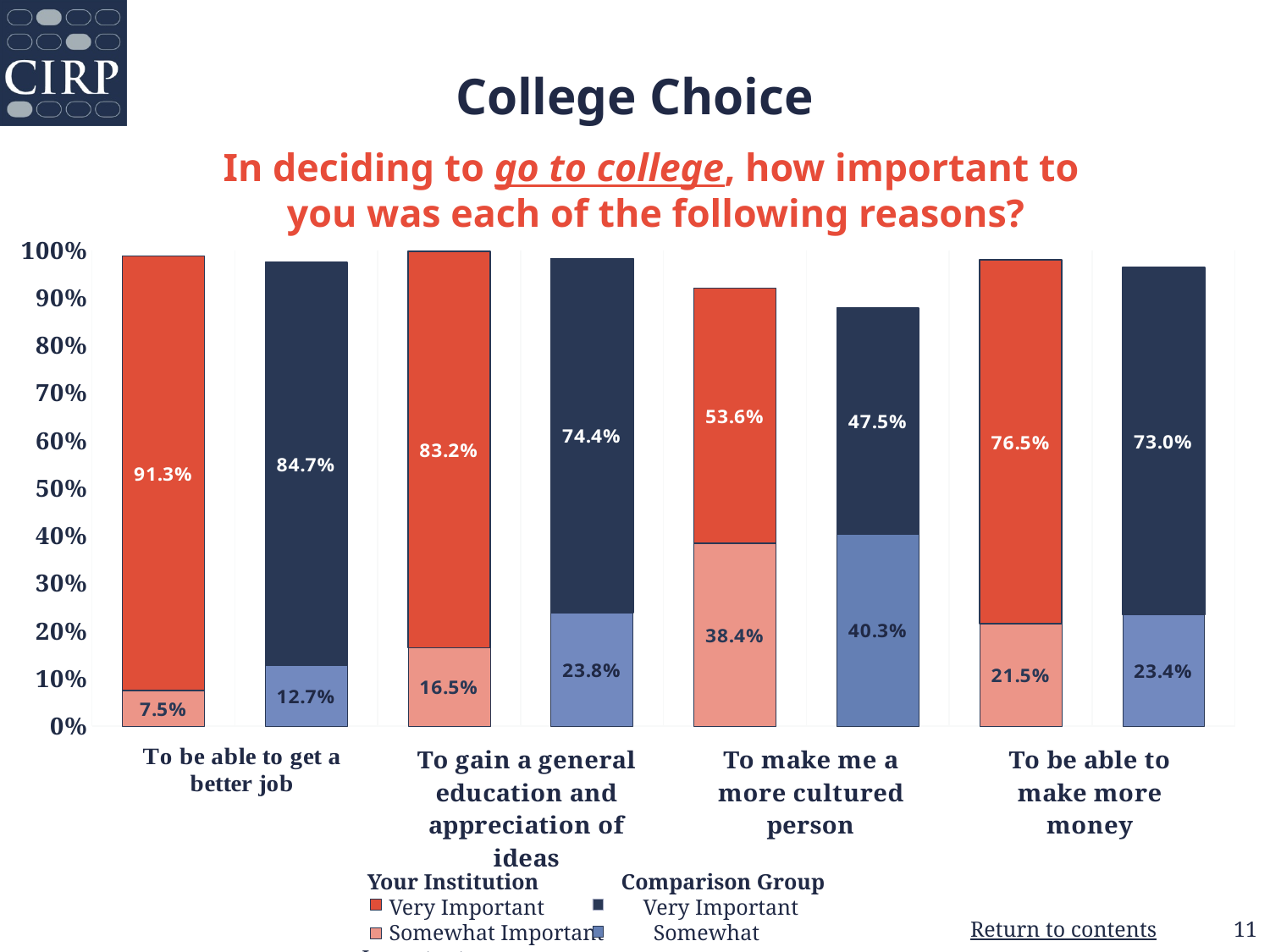
What is the Very Important percentage for the Comparison Group for "To be able to make more money"? 73.0% Which reason has the highest Very Important percentage for Your Institution? To be able to get a better job For "To be able to make more money", which is larger: the Your Institution Somewhat Important value or the Comparison Group Somewhat Important value? Comparison Group Somewhat Important Which reason has the lowest Very Important percentage for the Comparison Group? To make me a more cultured person What is the combined total of Very Important and Somewhat Important for the Comparison Group for "To be able to get a better job"? 97.4% What percentage of the Comparison Group rated "To make me a more cultured person" as Somewhat Important? 40.3% What percentage of Your Institution students rated "To be able to get a better job" as Very Important? 91.3% What is the combined total of Very Important and Somewhat Important for Your Institution for "To make me a more cultured person"? 92.0% What kind of chart is shown on the slide? Stacked bar chart What is the difference between the Your Institution and Comparison Group Very Important percentages for "To gain a general education and appreciation of ideas"? 8.8% How many series does the chart's legend list? 4 How many reasons (categories) are shown on the x axis of the chart? 4